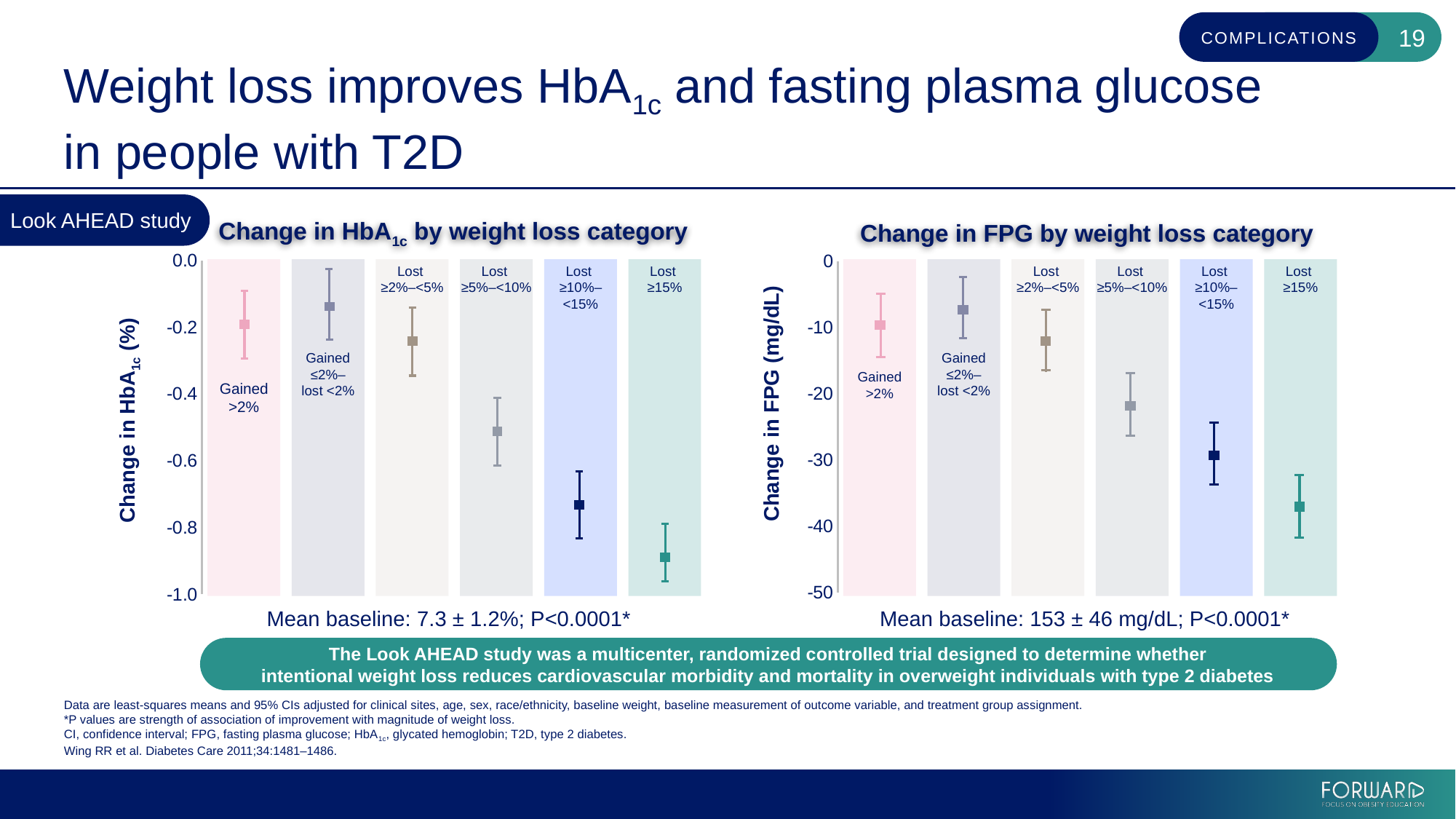
In the 'Change in HbA1c by weight loss category' chart, is the value for Lost ≥10%–<15% greater or less than -0.6? less In the 'Change in HbA1c by weight loss category' chart, which category shows a larger reduction in HbA1c: Gained >2% or Lost ≥15%? Lost ≥15% In the 'Change in FPG by weight loss category' chart, is the value for Lost ≥15% greater or less than -30? less In the 'Change in FPG by weight loss category' chart, which category shows the largest reduction in FPG? Lost ≥15% What is the y-axis label of the 'Change in FPG by weight loss category' chart? Change in FPG (mg/dL) In the 'Change in FPG by weight loss category' chart, do the plotted values generally rise or fall moving from the Gained ≤2%–lost <2% category to the Lost ≥15% category? fall In the 'Change in HbA1c by weight loss category' chart, which category shows the largest reduction in HbA1c? Lost ≥15% In the 'Change in HbA1c by weight loss category' chart, how many weight loss categories are plotted? 6 What mean baseline value is stated below the 'Change in HbA1c by weight loss category' chart? 7.3 ± 1.2% In the 'Change in FPG by weight loss category' chart, is the value for Gained ≤2%–lost <2% greater or less than -10? greater In the 'Change in FPG by weight loss category' chart, which category shows a larger reduction in FPG: Lost ≥2%–<5% or Lost ≥10%–<15%? Lost ≥10%–<15%